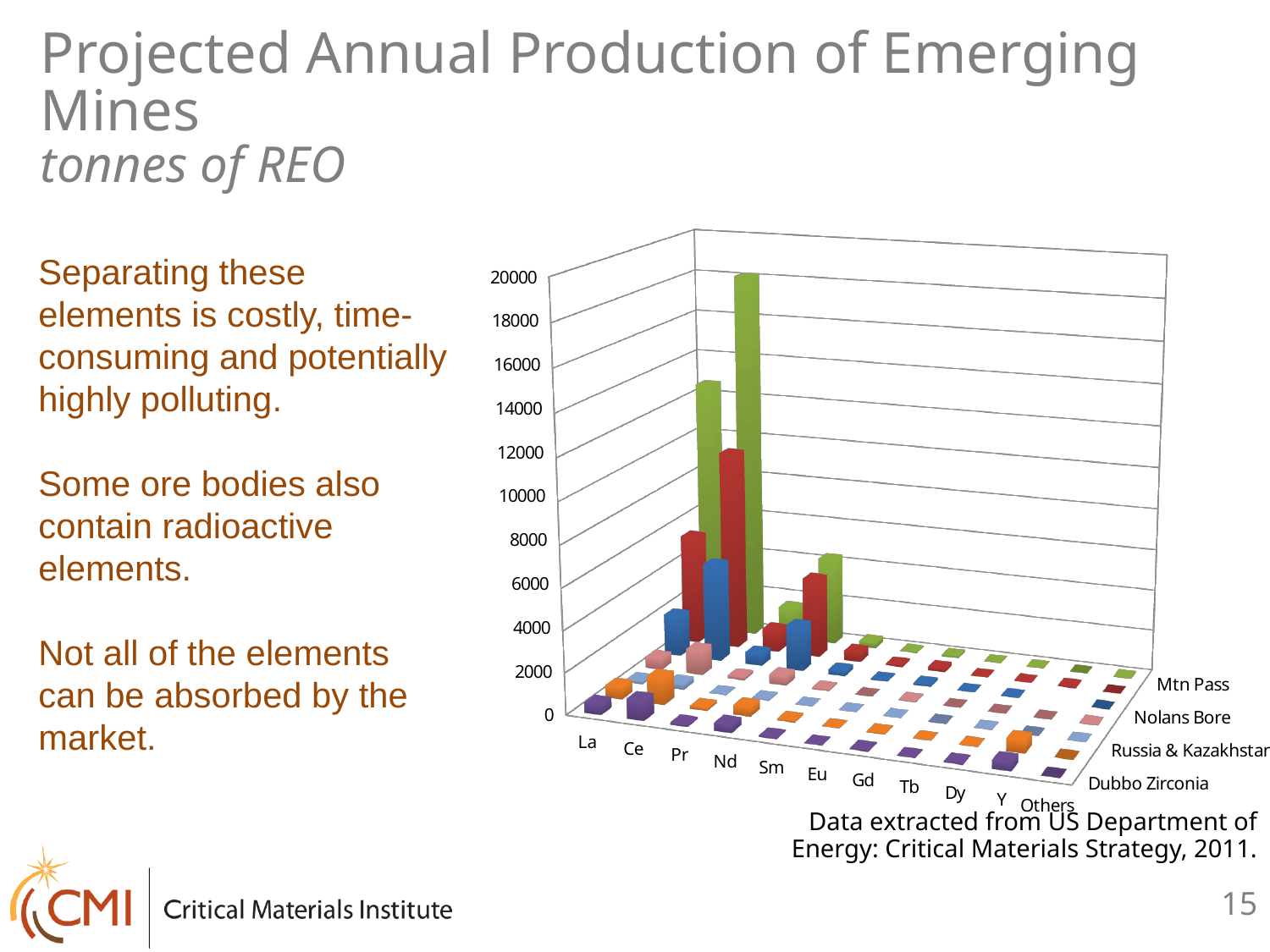
Which element has the highest projected production for Mtn Pass? Ce Is the Mtn Pass value for Nd greater or less than 10000? less How many element categories are shown along the x axis of the chart? 11 Do the Mtn Pass values generally rise or fall from Ce to Others along the x axis? fall For Ce, which mine has the larger projected production: Mtn Pass or Nolans Bore? Mtn Pass Which mine is listed in the front-most row of the chart's depth axis? Dubbo Zirconia What kind of chart is shown on the slide? bar chart What unit of measurement is given in the chart's subtitle? tonnes of REO Is the Mtn Pass value for Ce greater or less than 10000? greater Is the Mtn Pass value for Gd greater or less than 4000? less Which is larger for Mtn Pass: the value for Ce or the value for La? Ce